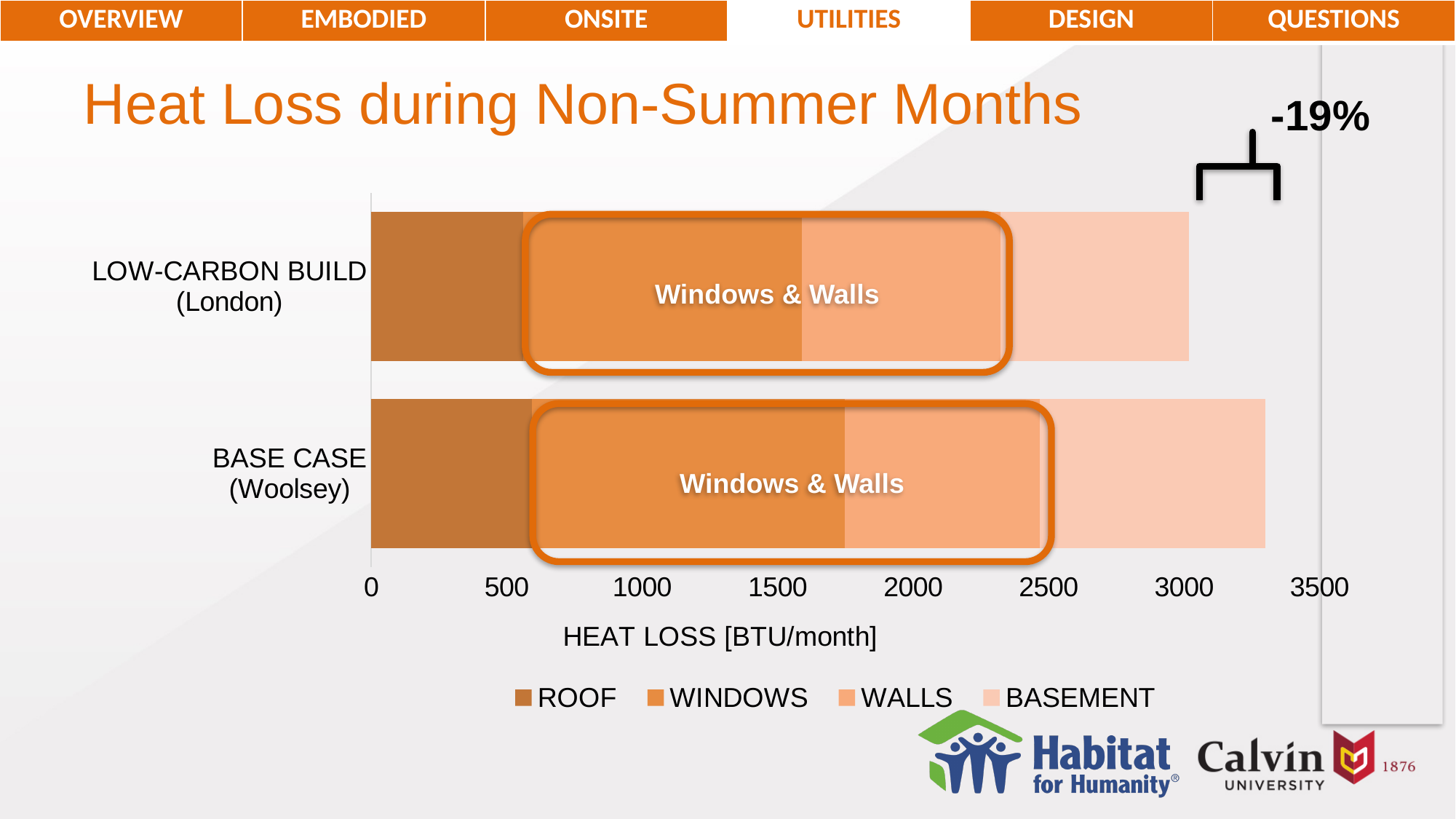
Which category has the lowest total heat loss? LOW-CARBON BUILD (London) Is the ROOF heat loss for BASE CASE (Woolsey) greater or less than 500? greater Which build has the larger total heat loss, LOW-CARBON BUILD (London) or BASE CASE (Woolsey)? BASE CASE (Woolsey) What kind of chart is shown on the slide? Stacked bar chart How many series does the chart legend list? 4 How many categories (builds) are plotted on the chart? 2 Is the total heat loss for BASE CASE (Woolsey) greater or less than 3500? less What is the label of the horizontal axis? HEAT LOSS [BTU/month] Is the total heat loss for LOW-CARBON BUILD (London) greater or less than 3500? less What is the title of the chart on the slide? Heat Loss during Non-Summer Months